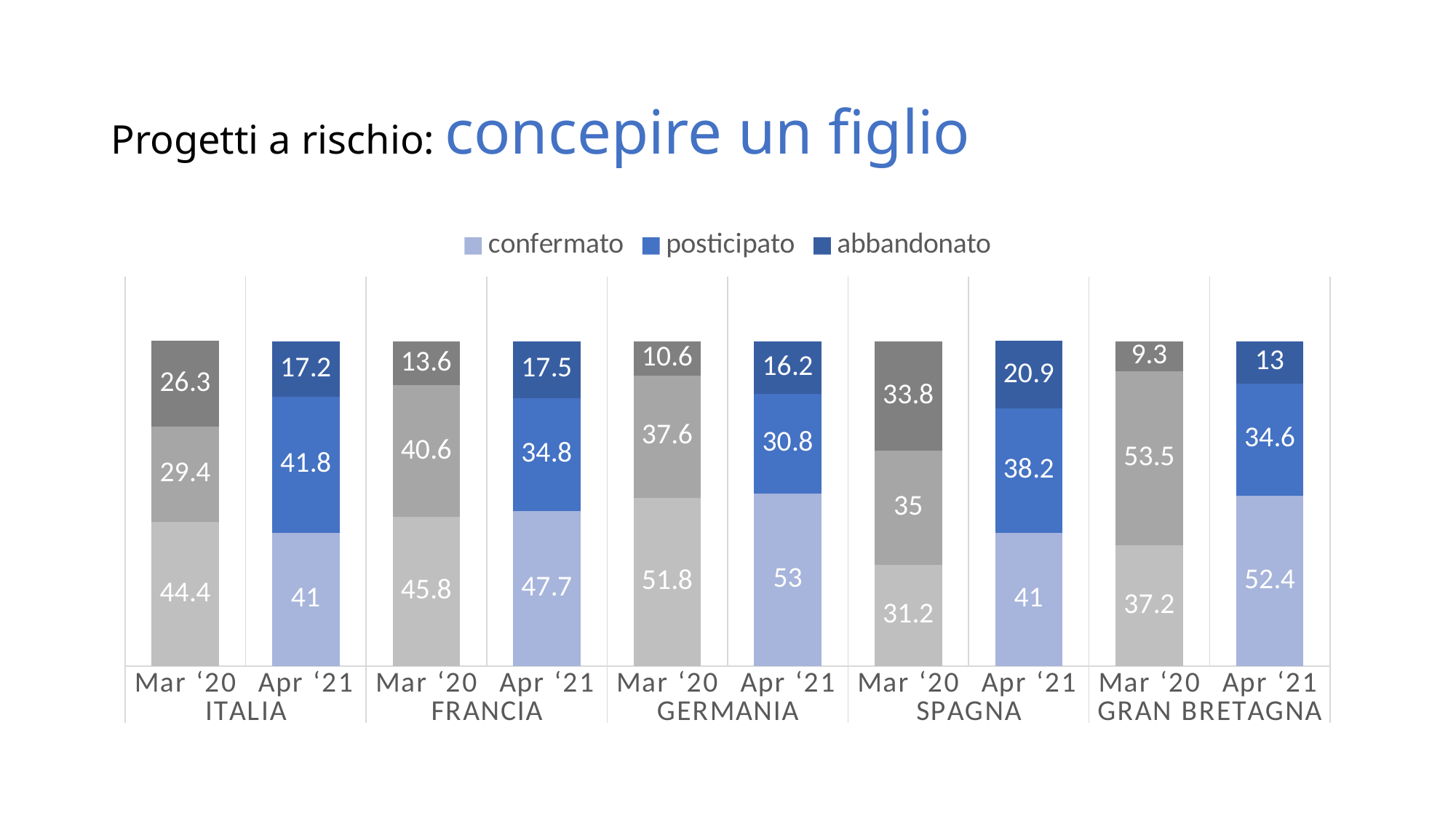
What is the total of the stacked bar for Francia in Mar '20? 100 What is the 'abbandonato' value for Gran Bretagna in Mar '20? 9.3 What is the 'confermato' value for Italia in Mar '20? 44.4 How many stacked bars are shown in the chart? 10 What are the three legend entries of the chart? confermato, posticipato, abbandonato How many series does the legend list? 3 What kind of chart is shown on the slide? Stacked bar chart What is the difference between the 'abbandonato' values for Italia in Mar '20 and Apr '21? 9.1 For Francia, is the 'posticipato' value larger in Mar '20 or Apr '21? Mar '20 Which bar has the highest 'confermato' value? Germania Apr '21 What is the 'posticipato' value for Spagna in Apr '21? 38.2 Which bar has the lowest 'abbandonato' value? Gran Bretagna Mar '20